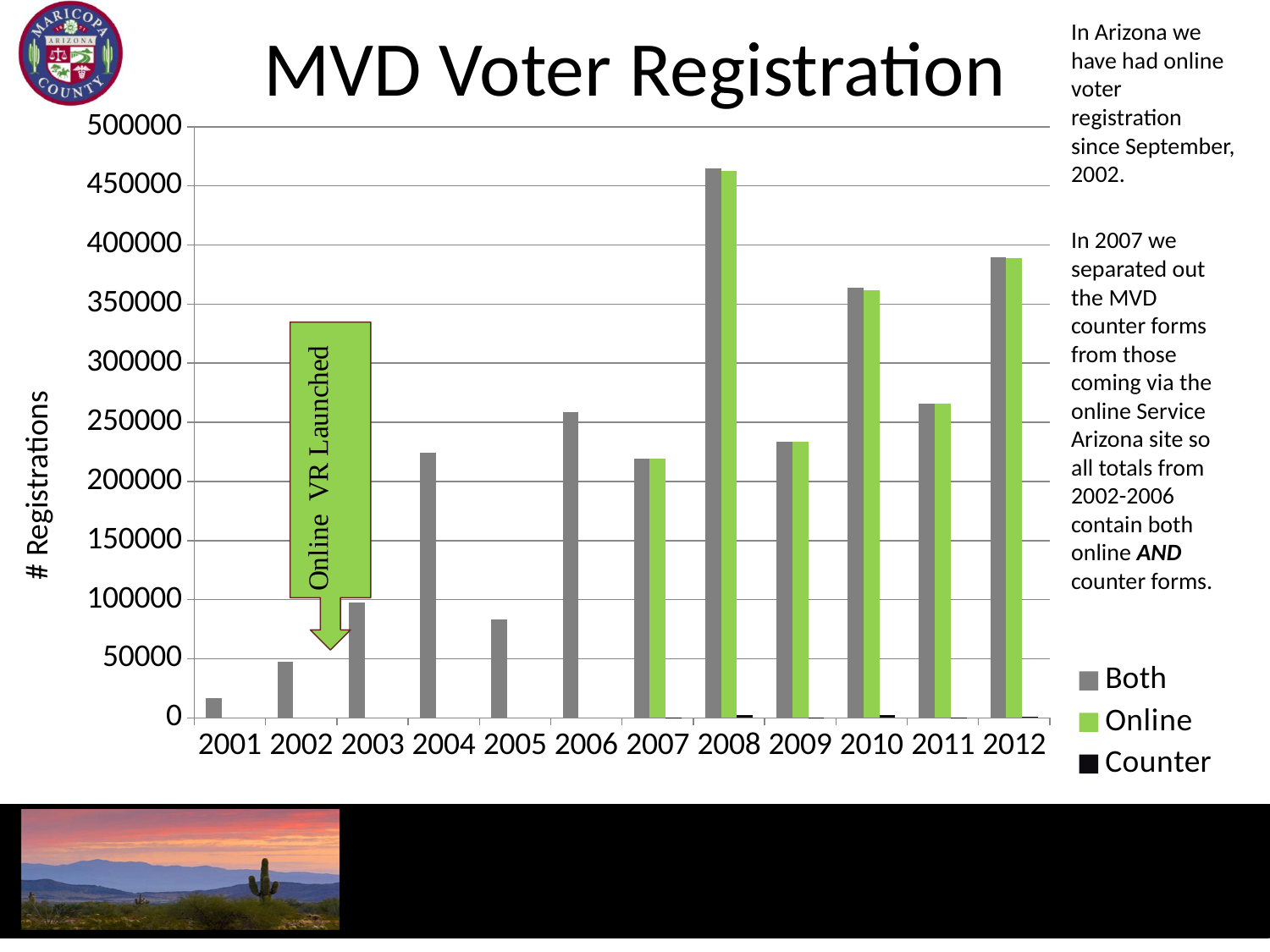
What is the label on the chart's y axis? # Registrations How many years are shown along the x axis of the chart? 12 What kind of chart is shown on the slide? bar chart Which year has the highest number of registrations in the 'Both' series? 2008 Is the 'Both' value for 2012 greater or less than 350000? greater Which year has the larger 'Both' value, 2010 or 2011? 2010 Is the 'Both' value for 2008 greater or less than 450000? greater What is the title of the chart? MVD Voter Registration Which year has the lowest number of registrations in the 'Both' series? 2001 How many series does the chart's legend list? 3 Is the 'Both' value for 2005 greater or less than 100000? less Do the 'Both' values rise or fall from 2001 to 2004? rise